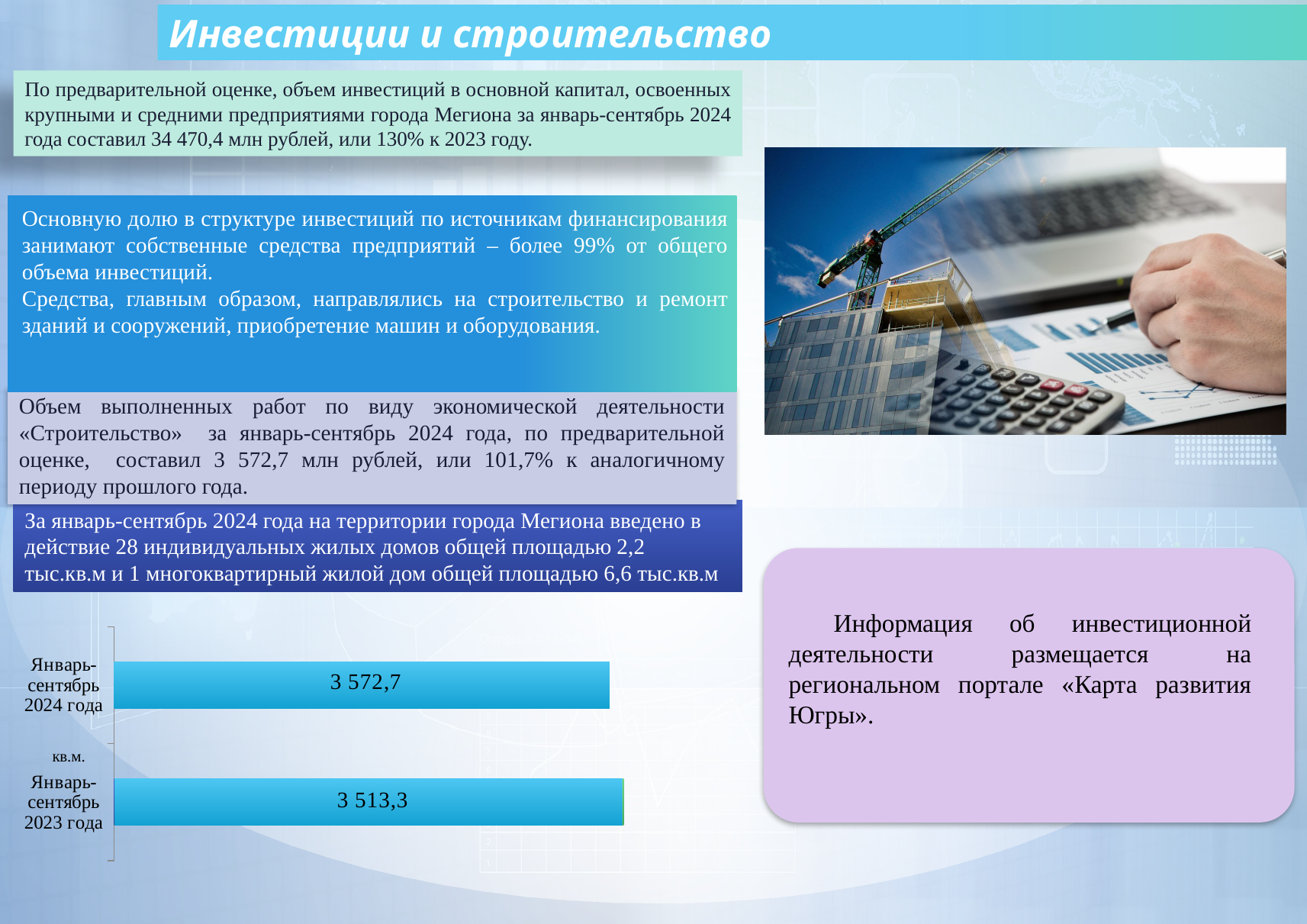
How many categories are shown in the bar chart? 2 According to the data labels, which category has the lowest value in the bar chart? Январь-сентябрь 2023 года What is the value shown for Январь-сентябрь 2024 года in the bar chart? 3 572,7 What is the value shown for Январь-сентябрь 2023 года in the bar chart? 3 513,3 What colour are the bars in the chart? Blue Are the bars in the chart oriented horizontally or vertically? Horizontally According to the data labels, which category has the highest value in the bar chart? Январь-сентябрь 2024 года According to the data labels, which period has the larger value: Январь-сентябрь 2024 года or Январь-сентябрь 2023 года? Январь-сентябрь 2024 года By how much does the value for Январь-сентябрь 2024 года exceed the value for Январь-сентябрь 2023 года in the bar chart? 59,4 What type of chart is shown at the bottom left of the slide? Bar chart